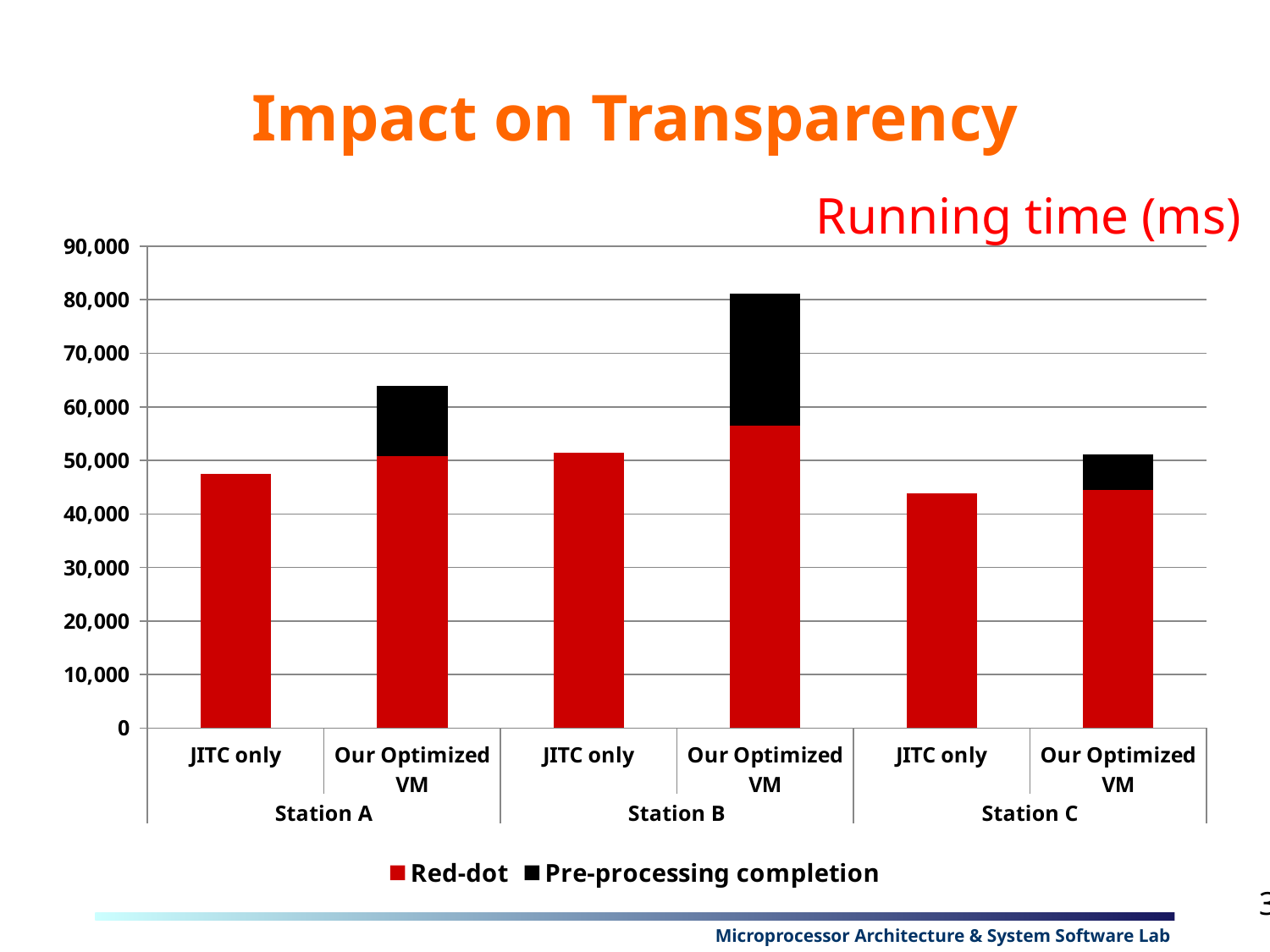
How many bars are plotted in the chart? 6 Which bar has the lowest total running time? Station C, JITC only How many stations are shown along the x axis? 3 What kind of chart is shown on the slide? bar chart How many series does the legend list? 2 Is the running time for JITC only at Station A greater or less than 50,000? less Which is larger: the JITC only running time at Station A or at Station B? Station B Which bar has the largest Pre-processing completion segment? Station B, Our Optimized VM Is the total running time for Our Optimized VM at Station A greater or less than 60,000? greater Which bar has the highest total running time? Station B, Our Optimized VM Is the total running time for Our Optimized VM at Station B greater or less than 70,000? greater What are the two series named in the legend? Red-dot and Pre-processing completion